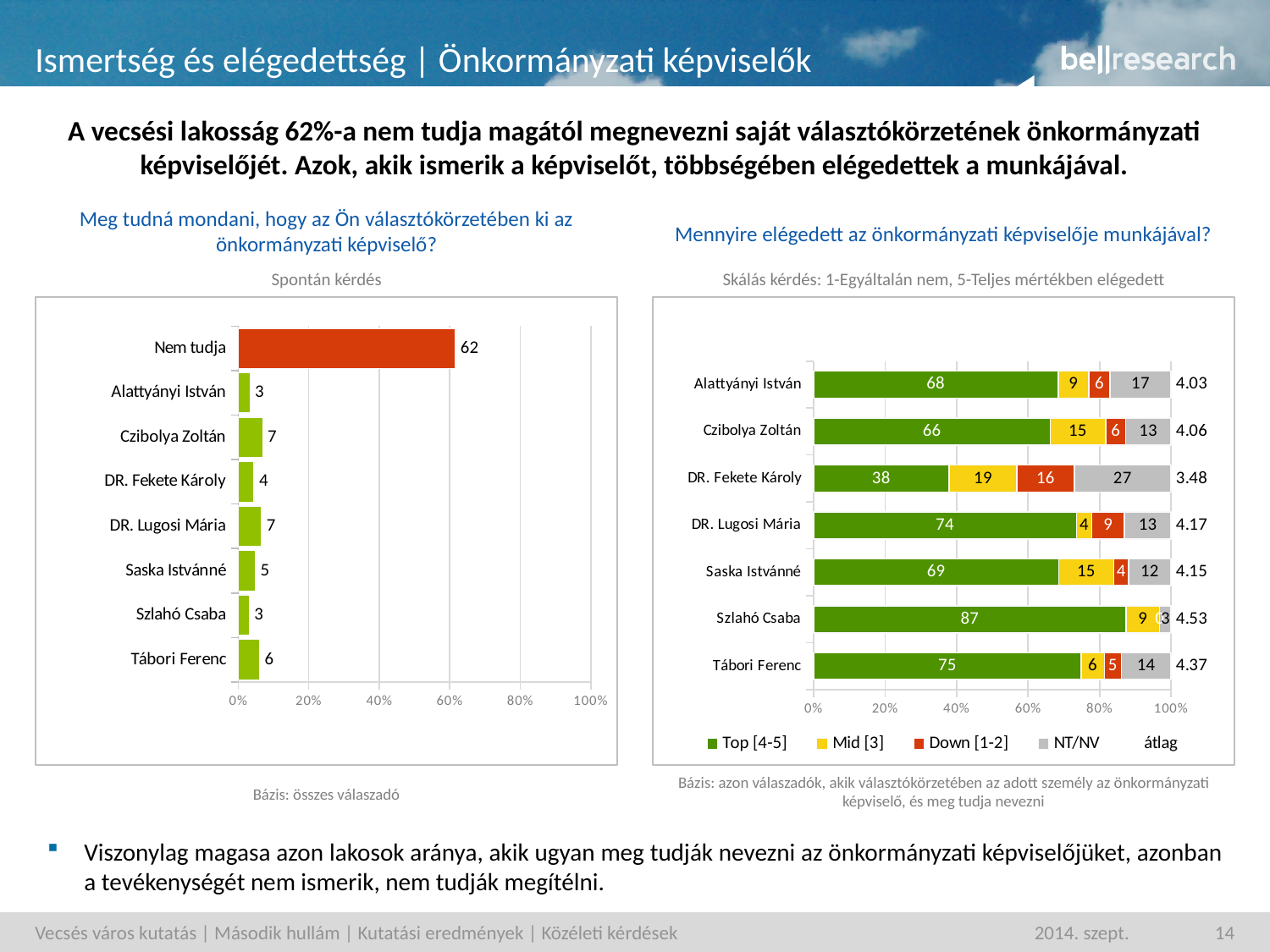
In the right chart (Mennyire elégedett...), which is larger: the Top [4-5] value for DR. Lugosi Mária or for Saska Istvánné? DR. Lugosi Mária In the left chart (Meg tudná mondani...), what is the value for Nem tudja? 62 In the right chart (Mennyire elégedett...), what is the NT/NV value for Alattyányi István? 17 In the left chart (Meg tudná mondani...), how many categories are shown? 8 In the right chart (Mennyire elégedett...), what is the Top [4-5] value for Szlahó Csaba? 87 In the right chart (Mennyire elégedett...), what is the átlag (average) for DR. Fekete Károly? 3.48 In the left chart (Meg tudná mondani...), what is the value for Tábori Ferenc? 6 In the left chart (Meg tudná mondani...), what is the difference between the values for Czibolya Zoltán and Alattyányi István? 4 In the left chart (Meg tudná mondani...), which category has the highest value? Nem tudja In the right chart (Mennyire elégedett...), what is the difference between the Mid [3] values for DR. Fekete Károly and Tábori Ferenc? 13 In the right chart (Mennyire elégedett...), which person has the lowest Top [4-5] value? DR. Fekete Károly In the left chart (Meg tudná mondani...), what kind of chart is it? Bar chart